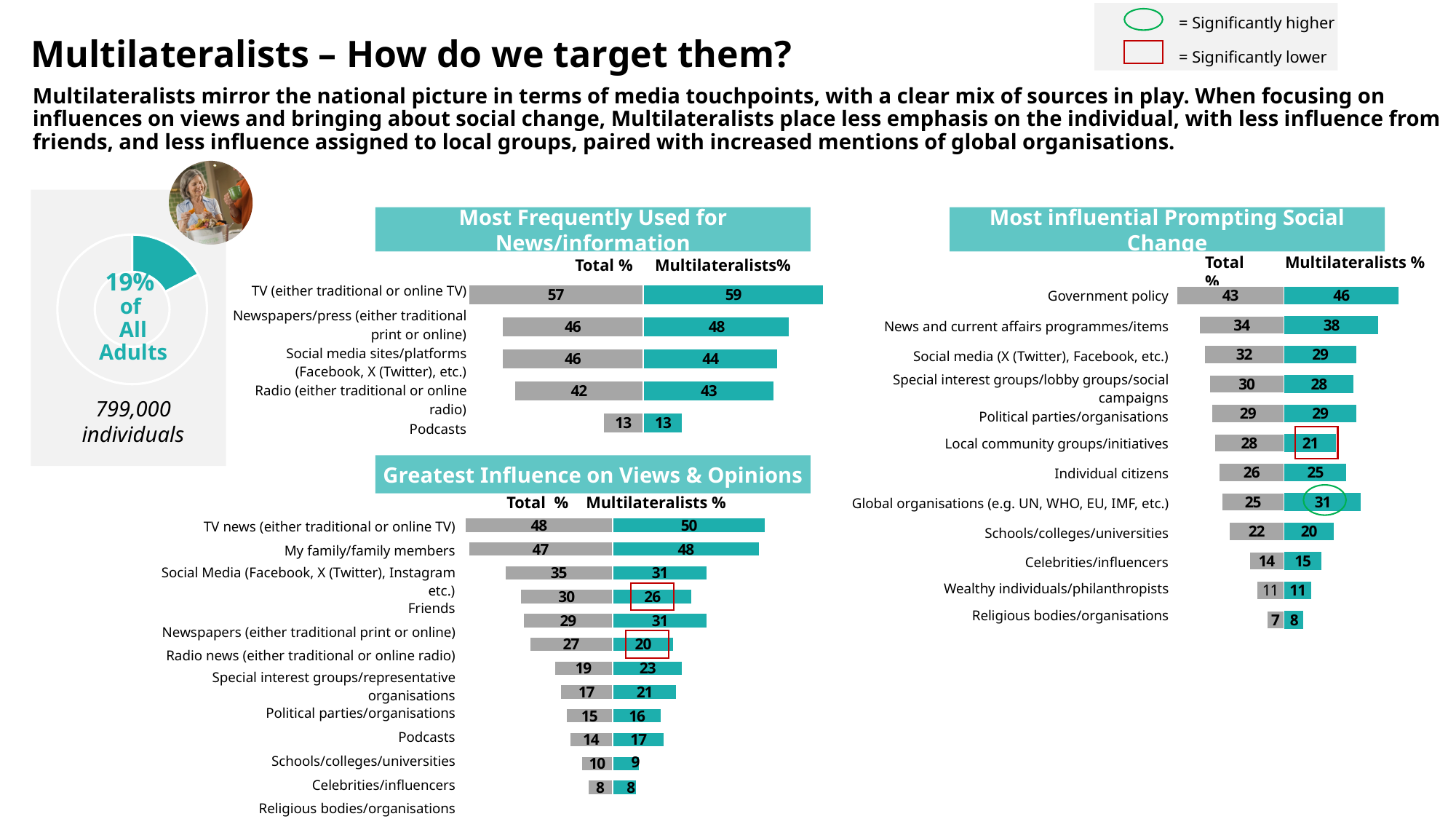
In the 'Most influential Prompting Social Change' chart, what is the Multilateralists % for Global organisations (e.g. UN, WHO, EU, IMF, etc.)? 31 In the 'Most Frequently Used for News/information' chart, how many categories are shown? 5 In the 'Greatest Influence on Views & Opinions' chart, what is the Multilateralists % for TV news (either traditional or online TV)? 50 In the 'Most Frequently Used for News/information' chart, what is the Multilateralists % for TV (either traditional or online TV)? 59 What share of all adults does the pie chart on the left show for Multilateralists? 19% In the 'Greatest Influence on Views & Opinions' chart, what is the Total % for My family/family members? 47 In the 'Most Frequently Used for News/information' chart, which category has the lowest Multilateralists %? Podcasts In the 'Most Frequently Used for News/information' chart, what is the Total % for Radio (either traditional or online radio)? 42 In the 'Most influential Prompting Social Change' chart, which is larger for Social media (X (Twitter), Facebook, etc.): the Total % or the Multilateralists %? Total % In the 'Most influential Prompting Social Change' chart, how many categories are listed? 12 In the 'Most influential Prompting Social Change' chart, which category has the highest Total %? Government policy In the 'Most influential Prompting Social Change' chart, what is the difference between the Total % and the Multilateralists % for Local community groups/initiatives? 7